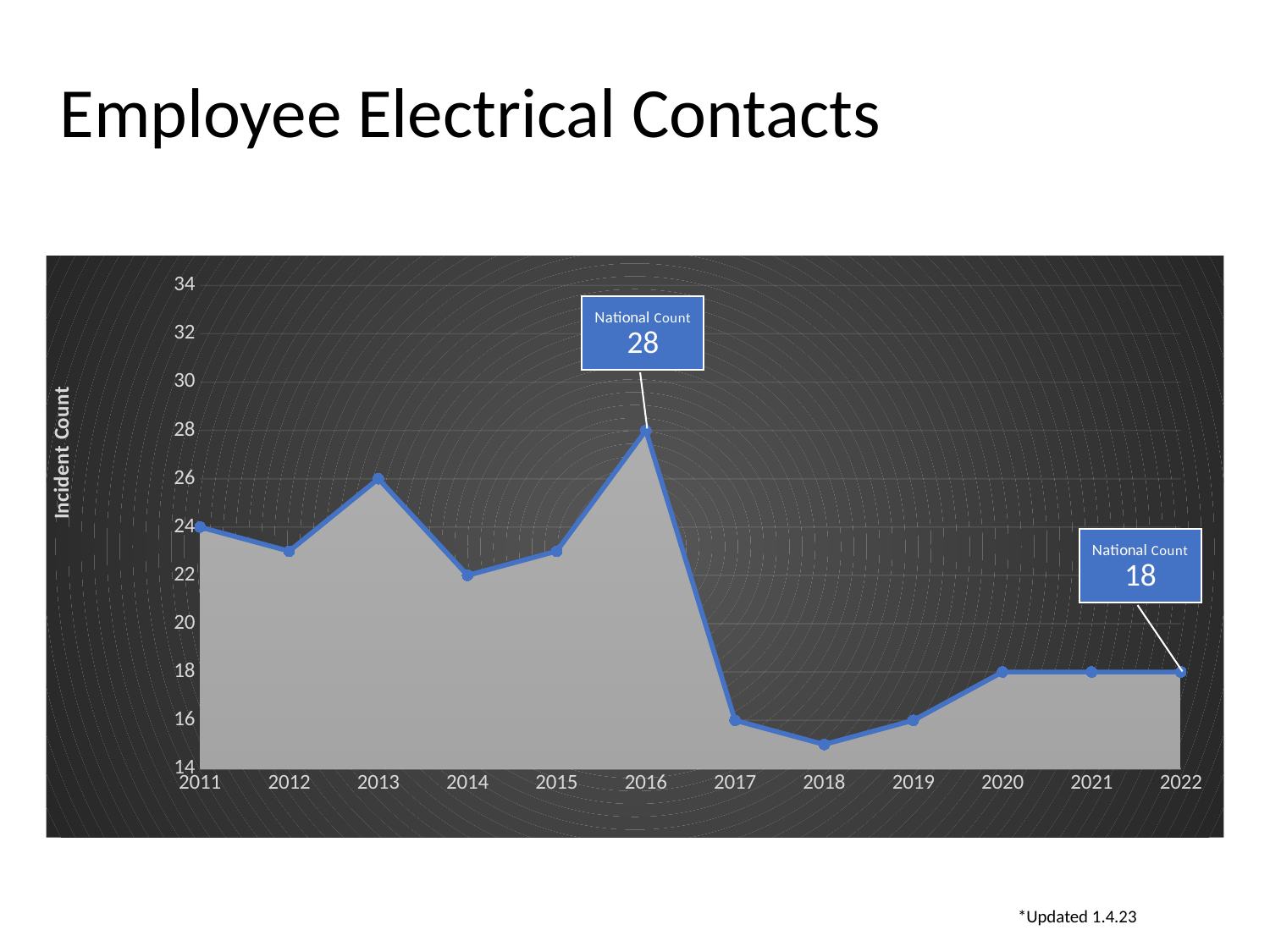
What is the difference between the 2016 value and the 2022 value? 10 How many years are plotted on the x axis? 12 What is the title of the vertical axis? Incident Count What kind of chart is shown on the slide? area chart Is the value for 2018 greater or less than 16? less Which year has a larger incident count, 2013 or 2017? 2013 What is the incident count for 2013? 26 Which year has the highest incident count? 2016 What is the incident count for 2011? 24 Which year has the lowest incident count? 2018 What is the National Count value labeled for 2016? 28 What is the National Count value labeled for 2022? 18